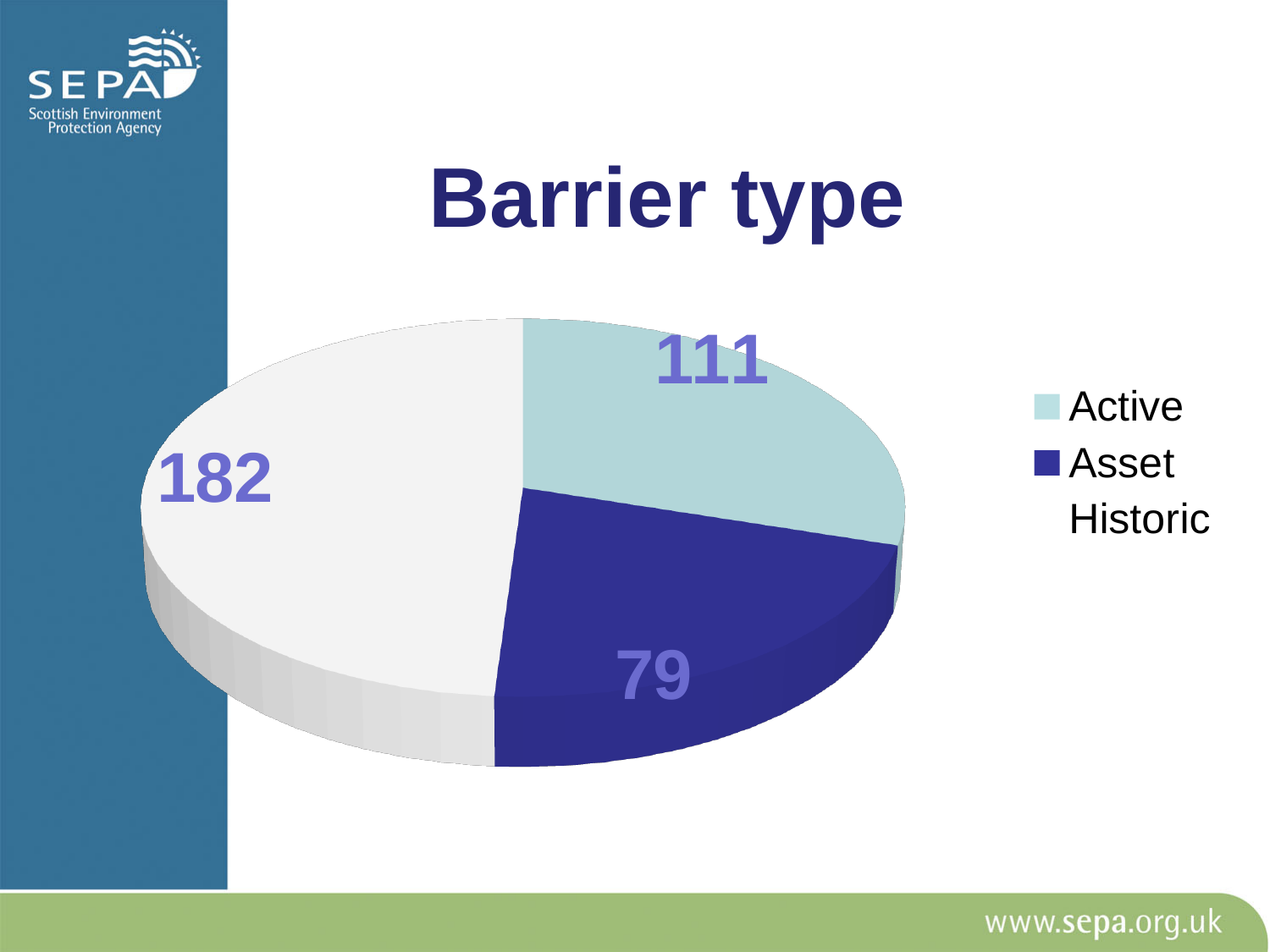
What is the difference between the Active and Asset values? 32 Which is larger, Active or Asset? Active What is the value for Historic? 182 How many slices does the pie chart have? 3 What is the value for Active? 111 What is the title of the chart? Barrier type Which barrier type has the largest slice? Historic What is the total of all slices in the pie chart? 372 Which barrier type has the smallest slice? Asset What is the value for Asset? 79 What is the difference between the Historic and Active values? 71 What type of chart is shown on the slide? Pie chart